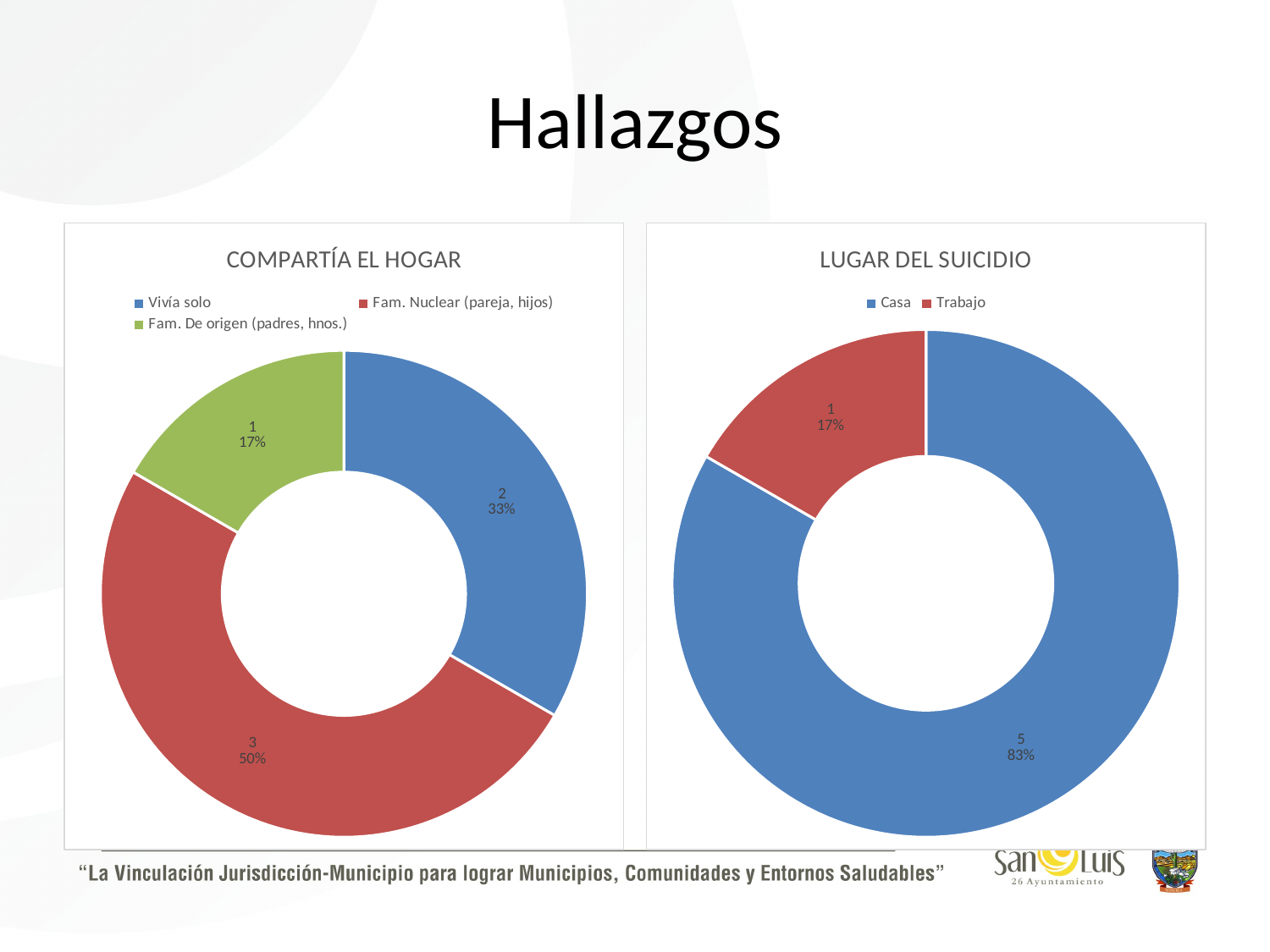
In the 'LUGAR DEL SUICIDIO' chart, what percentage share does 'Trabajo' have? 17% In the 'COMPARTÍA EL HOGAR' chart, what is the difference between the counts for 'Fam. Nuclear (pareja, hijos)' and 'Fam. De origen (padres, hnos.)'? 2 In the 'LUGAR DEL SUICIDIO' chart, which category is larger, 'Casa' or 'Trabajo'? Casa In the 'LUGAR DEL SUICIDIO' chart, what is the count for 'Casa'? 5 What kind of chart is the 'LUGAR DEL SUICIDIO' chart? Doughnut chart In the 'COMPARTÍA EL HOGAR' chart, what percentage share does 'Vivía solo' have? 33% In the 'COMPARTÍA EL HOGAR' chart, what is the count for 'Fam. Nuclear (pareja, hijos)'? 3 In the 'COMPARTÍA EL HOGAR' chart, how many categories does the legend list? 3 In the 'LUGAR DEL SUICIDIO' chart, what is the total count across both categories? 6 In the 'COMPARTÍA EL HOGAR' chart, which category has the largest share? Fam. Nuclear (pareja, hijos) In the 'COMPARTÍA EL HOGAR' chart, what colour represents 'Fam. De origen (padres, hnos.)'? Green In the 'COMPARTÍA EL HOGAR' chart, which category has the smallest share? Fam. De origen (padres, hnos.)